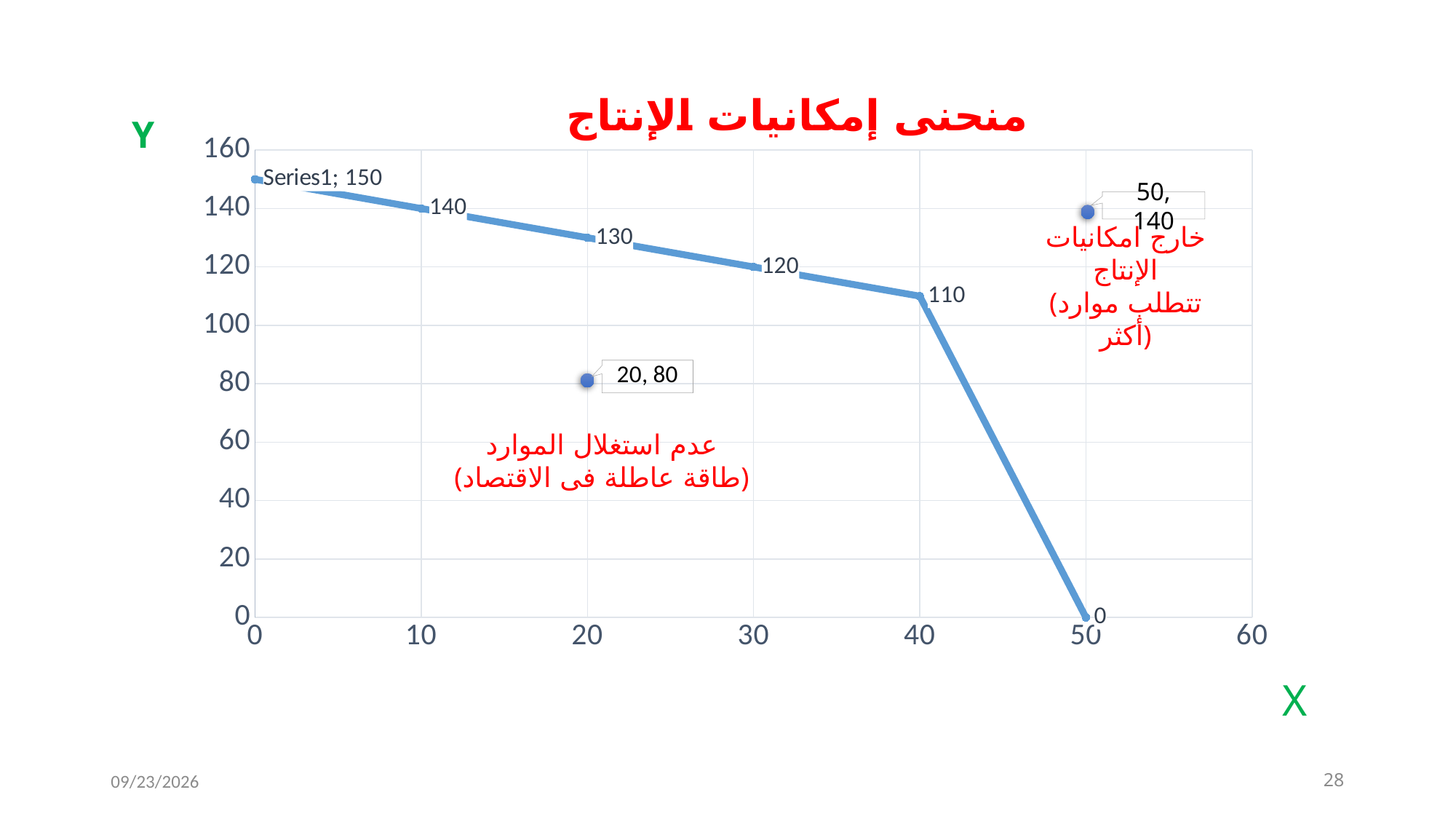
What is the difference between the curve's y value at x = 0 and its y value at x = 40? 40 What is the y value of the production possibilities curve at x = 30? 120 Does the y value of the production possibilities curve rise or fall as x increases? fall What is the y value of the production possibilities curve at x = 0? 150 What is the y value of the production possibilities curve at x = 40? 110 What is the y value of the production possibilities curve at x = 50? 0 At which x value does the production possibilities curve reach its highest y value? 0 What are the coordinates of the isolated point labelled outside the curve (above the line)? 50, 140 What is the y value of the production possibilities curve at x = 10? 140 What is the title of the chart? منحنى إمكانيات الإنتاج What are the coordinates of the isolated point labelled inside the curve (below the line)? 20, 80 At which x value does the production possibilities curve reach its lowest y value? 50